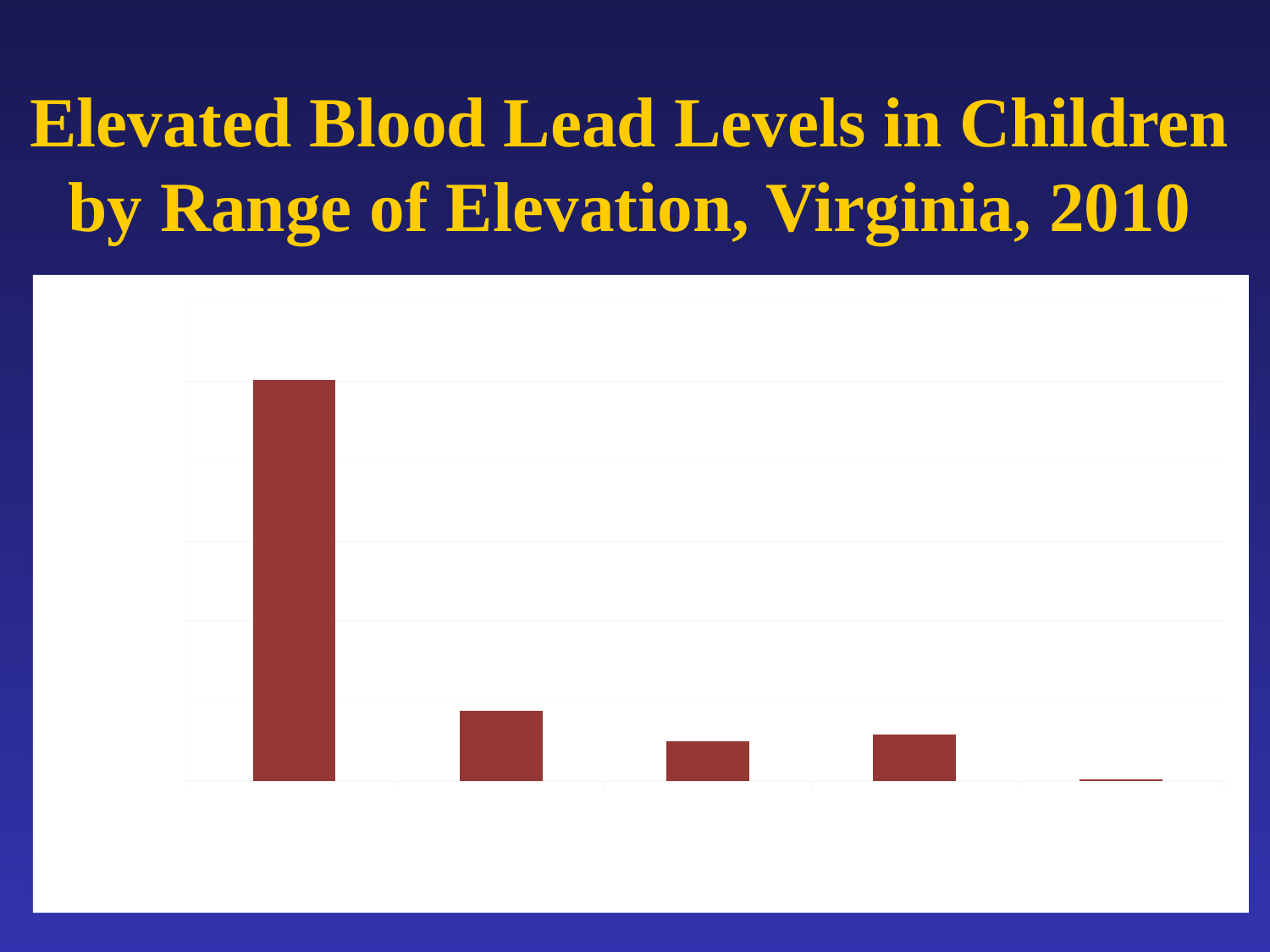
Do the bar values generally rise or fall from left to right across the chart? Fall Which bar in the chart is the tallest? The leftmost (first) bar Which is larger, the second bar from the left or the fifth bar from the left? The second bar What is the title shown above the chart on the slide? Elevated Blood Lead Levels in Children by Range of Elevation, Virginia, 2010 Which is larger, the second bar from the left or the third bar from the left? The second bar How many bars are plotted in the chart? 5 Which is larger, the first bar from the left or the fourth bar from the left? The first bar Which bar in the chart is the shortest? The rightmost (fifth) bar What colour are the bars in the chart? Dark red What kind of chart is shown on the slide? Bar chart